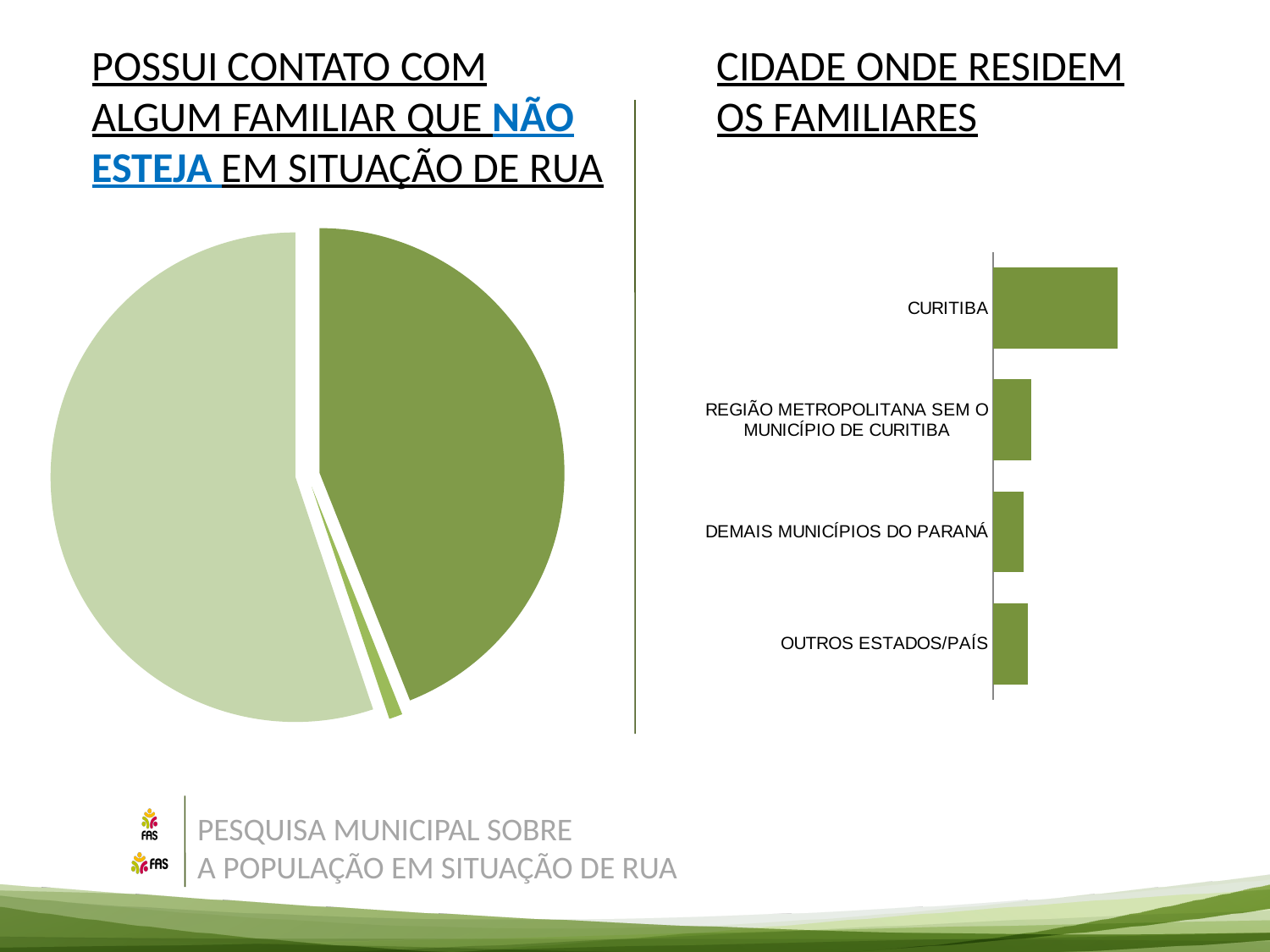
In the bar chart 'CIDADE ONDE RESIDEM OS FAMILIARES', which category has the highest value? CURITIBA What is the title of the bar chart on the right of the slide? CIDADE ONDE RESIDEM OS FAMILIARES What kind of chart is the chart on the right of the slide, titled 'CIDADE ONDE RESIDEM OS FAMILIARES'? bar chart How many slices does the pie chart on the left of the slide have? 3 What kind of chart is the chart on the left of the slide? pie chart In the bar chart 'CIDADE ONDE RESIDEM OS FAMILIARES', which is larger: CURITIBA or DEMAIS MUNICÍPIOS DO PARANÁ? CURITIBA In the bar chart 'CIDADE ONDE RESIDEM OS FAMILIARES', which is larger: CURITIBA or REGIÃO METROPOLITANA SEM O MUNICÍPIO DE CURITIBA? CURITIBA In the bar chart 'CIDADE ONDE RESIDEM OS FAMILIARES', which category is listed at the top? CURITIBA How many categories does the bar chart 'CIDADE ONDE RESIDEM OS FAMILIARES' show? 4 In the bar chart 'CIDADE ONDE RESIDEM OS FAMILIARES', which is larger: CURITIBA or OUTROS ESTADOS/PAÍS? CURITIBA